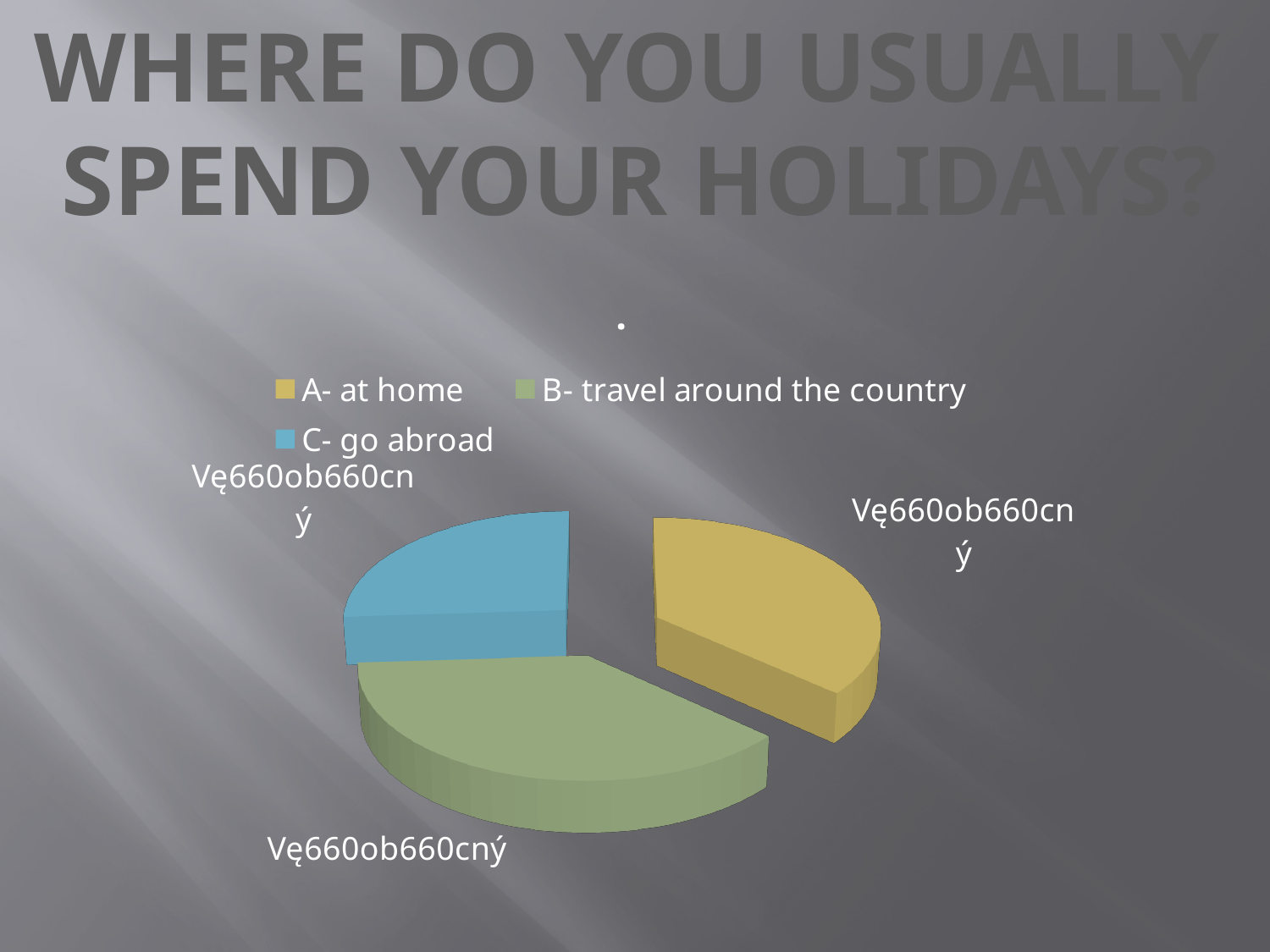
What colour is the slice for C- go abroad? blue Which slice is larger: B- travel around the country or A- at home? B- travel around the country What kind of chart is shown on the slide? pie chart Which category has the largest slice in the pie chart? B- travel around the country How many slices does the pie chart have? 3 How many entries does the legend of the pie chart list? 3 Which slice is larger: B- travel around the country or C- go abroad? B- travel around the country What colour is the slice for A- at home? yellow